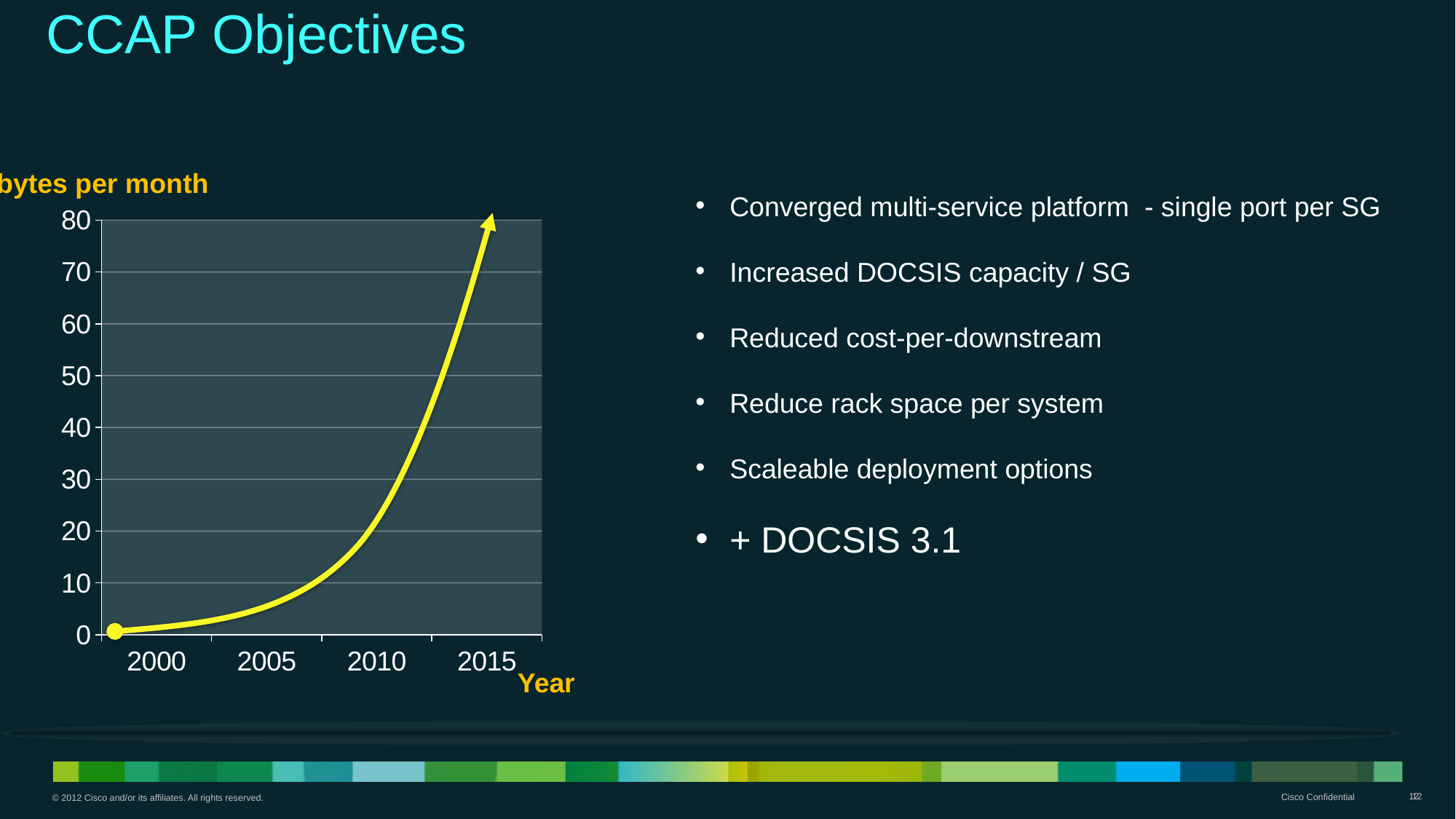
What is the label of the x axis of the chart? Year How many lines are plotted on the chart? 1 How many year labels are shown on the x axis of the chart? 4 What kind of chart is shown on the slide? line chart Do the values on the chart rise or fall as the year increases? rise Is the value for 2015 greater or less than 40? greater Is the value for 2010 greater or less than 40? less Is the value for 2010 greater or less than 10? greater What is the highest value shown on the y axis of the chart? 80 Which is larger, the value for 2005 or the value for 2015? 2015